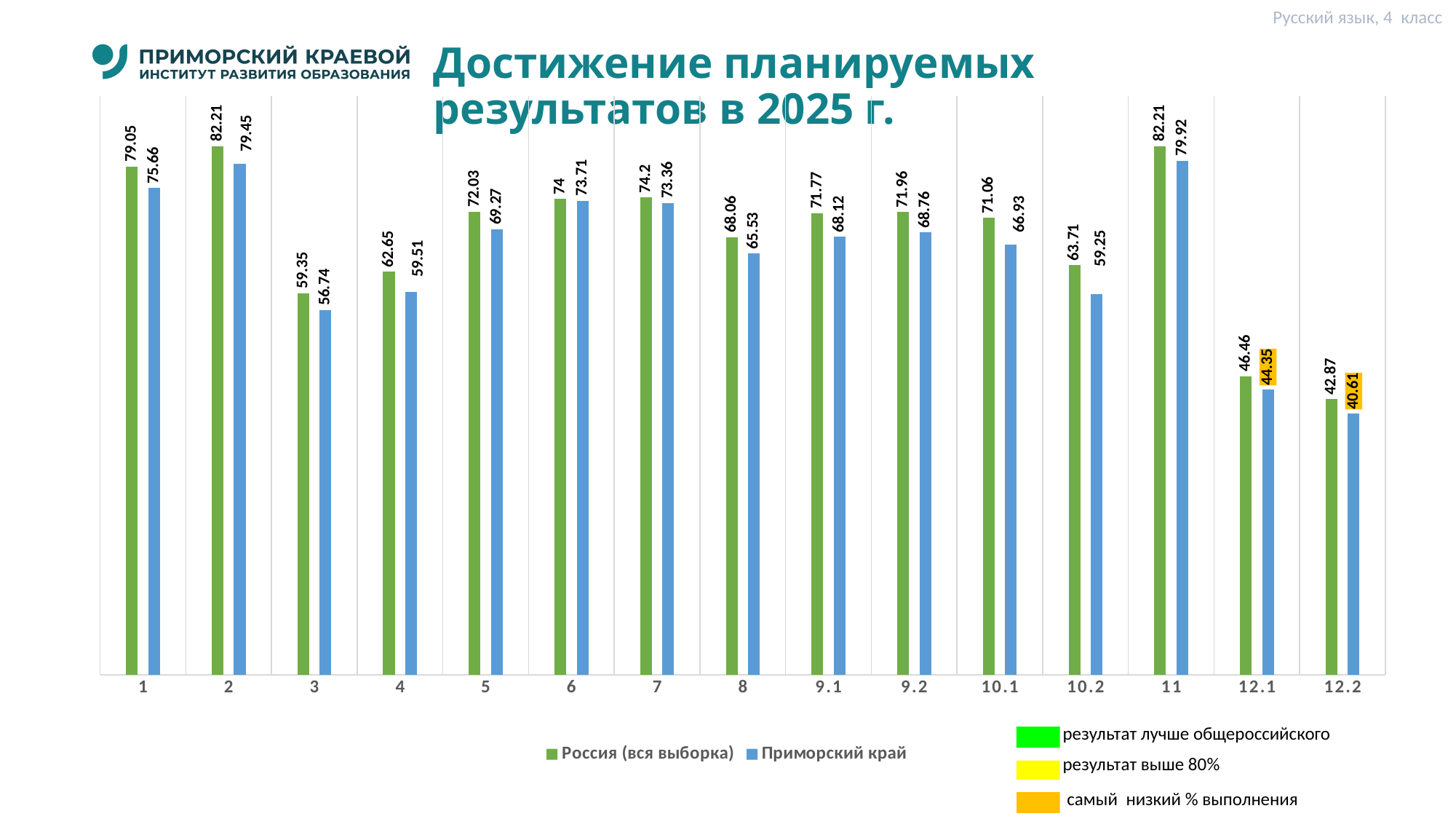
What is the value for Приморский край for task 12.2? 40.61 How many series does the legend list? 2 Which task has the lowest value for Россия (вся выборка)? 12.2 How many tasks (categories) are shown on the x axis? 15 What is the value for Приморский край for task 5? 69.27 What kind of chart is shown on the slide? Bar chart What is the difference between the Приморский край values for task 2 and task 3? 22.71 Which is larger for task 6: Россия (вся выборка) or Приморский край? Россия (вся выборка) Which task has the highest value for Приморский край? 11 What is the value for Россия (вся выборка) for task 9.2? 71.96 Which colour represents Приморский край in the chart? Blue What is the difference between Россия (вся выборка) and Приморский край for task 10.1? 4.13